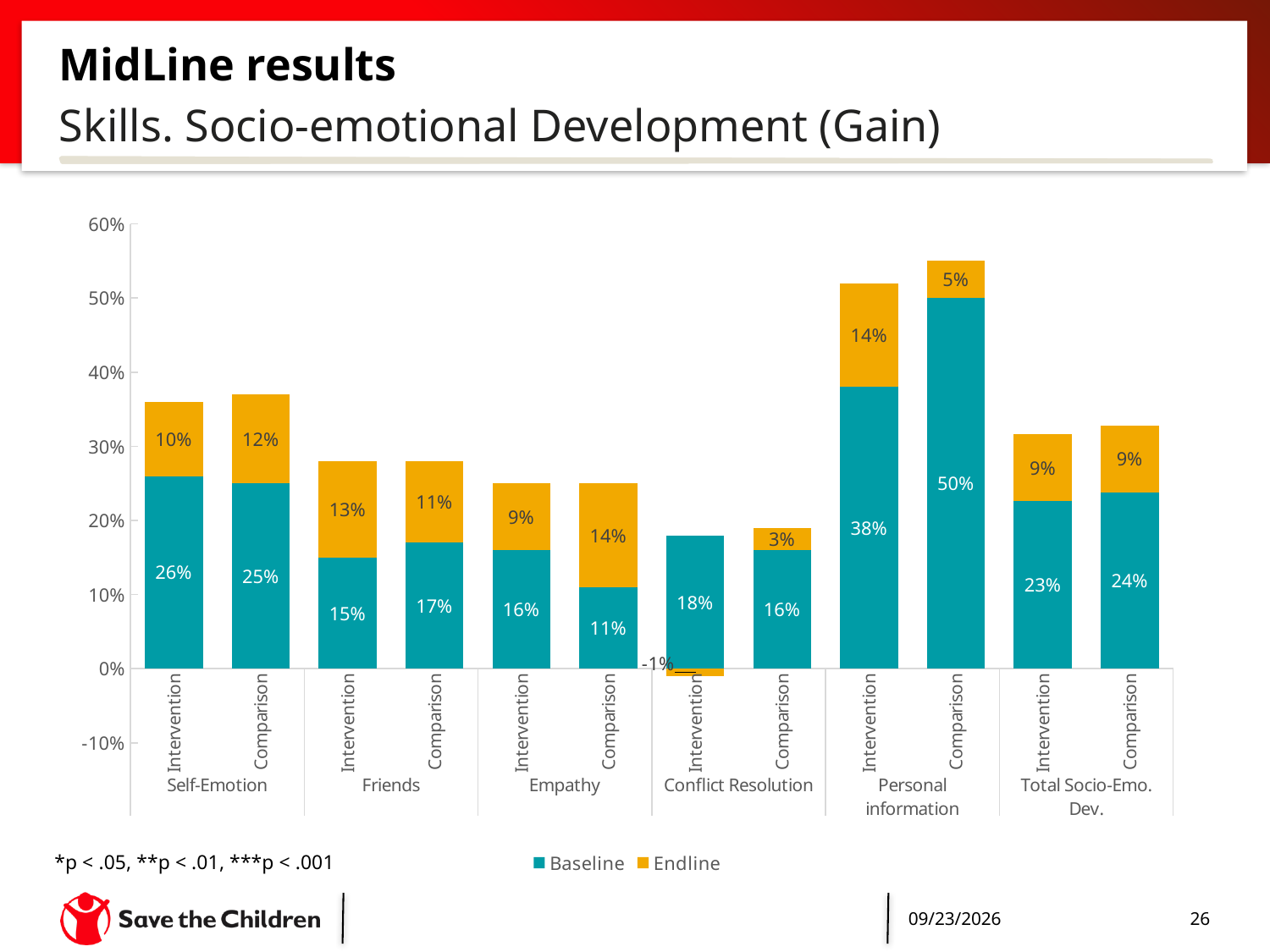
What is the Baseline value for the Personal information Comparison bar? 50% What is the Baseline value for the Empathy Comparison bar? 11% What kind of chart is shown on the slide? Stacked bar chart What is the total of the stacked bar for Total Socio-Emo. Dev. Comparison? 33% Which bar has the highest Baseline value? Personal information Comparison Which is larger, the Endline value for Friends Intervention or the Endline value for Friends Comparison? Friends Intervention Which bar has the lowest Endline value? Conflict Resolution Intervention How many bars are plotted in the chart? 12 What is the Endline value for the Conflict Resolution Intervention bar? -1% What is the difference between the Baseline values for Personal information Comparison and Personal information Intervention? 12% What is the Endline value for the Self-Emotion Intervention bar? 10% How many series does the legend list? 2